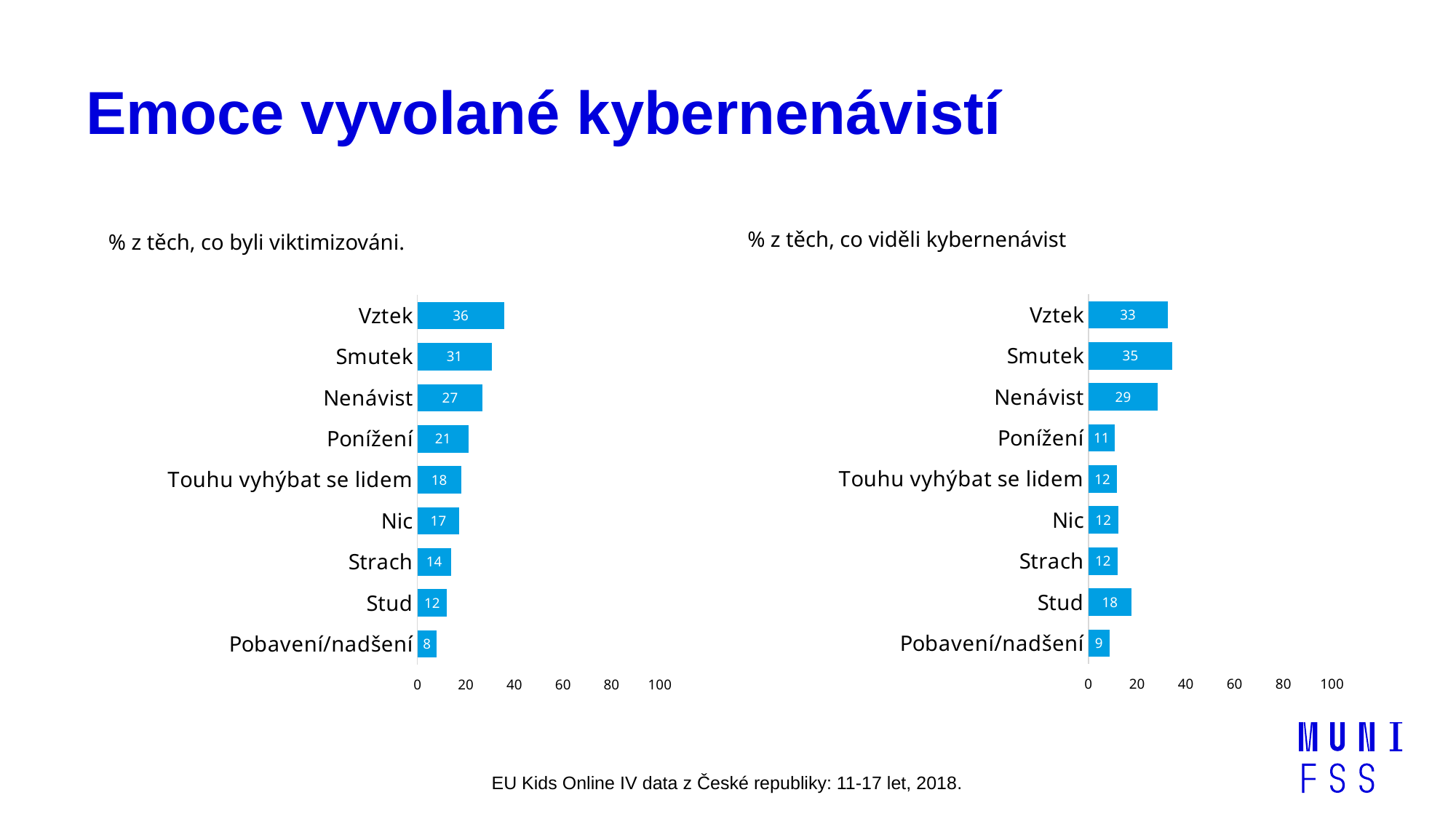
In the left chart (% z těch, co byli viktimizováni), what is the value for Vztek? 36 In the right chart (% z těch, co viděli kybernenávist), which category has the lowest value? Pobavení/nadšení In the left chart (% z těch, co byli viktimizováni), which is larger, the value for Ponížení or the value for Nic? Ponížení What is the title of the slide? Emoce vyvolané kybernenávistí In the right chart (% z těch, co viděli kybernenávist), is the value for Vztek greater or less than 20? greater In the right chart (% z těch, co viděli kybernenávist), what is the value for Stud? 18 What kind of chart is the right chart (% z těch, co viděli kybernenávist)? bar chart In the right chart (% z těch, co viděli kybernenávist), what is the value for Smutek? 35 In the left chart (% z těch, co byli viktimizováni), which category has the highest value? Vztek How many categories are shown in the left chart (% z těch, co byli viktimizováni)? 9 In the right chart (% z těch, co viděli kybernenávist), what is the difference between the values for Nenávist and Ponížení? 18 In the left chart (% z těch, co byli viktimizováni), what is the difference between the values for Vztek and Stud? 24